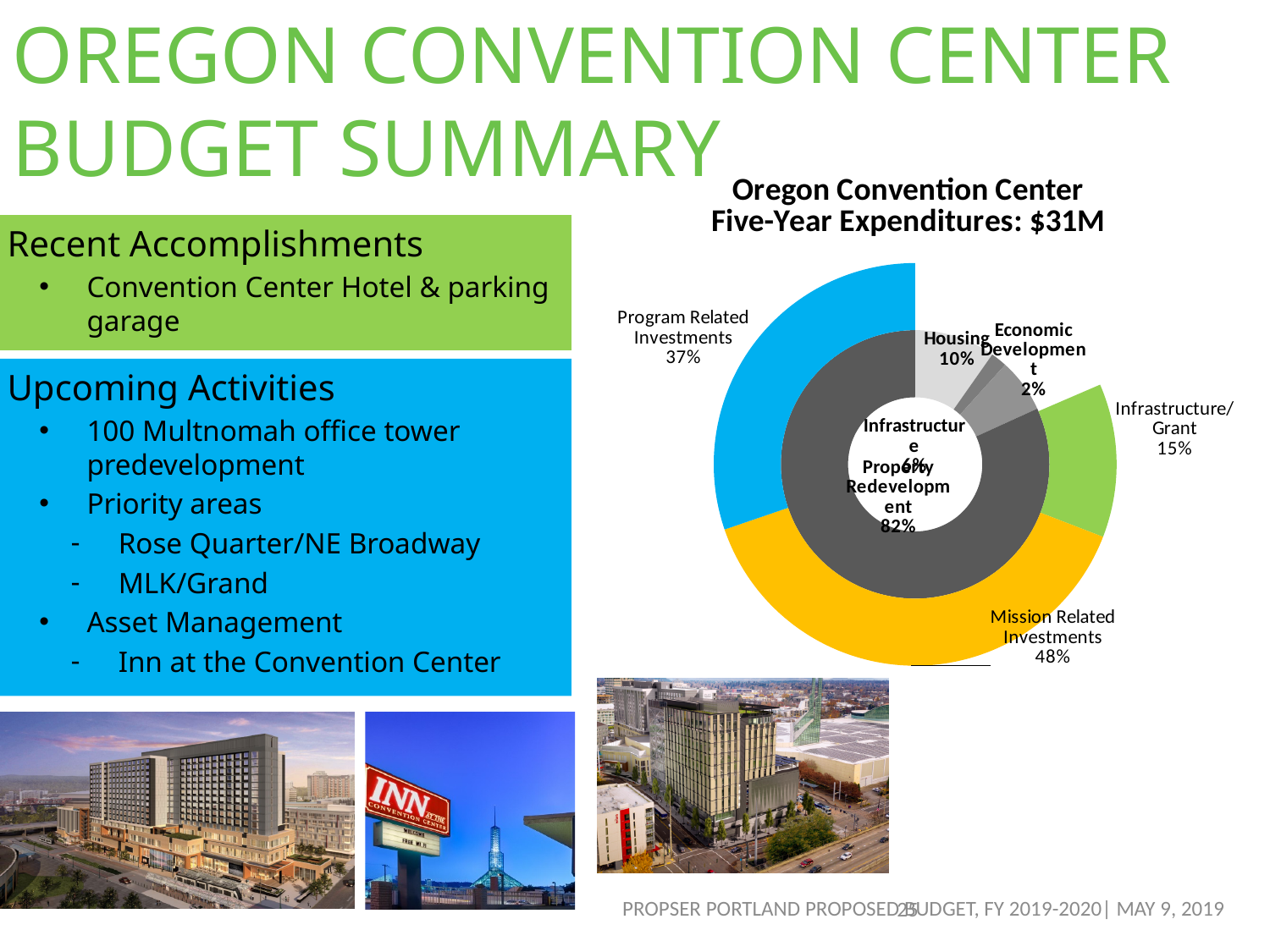
In the inner ring of the Oregon Convention Center expenditures chart, what percentage is labelled for Economic Development? 2% What kind of chart is shown under the title "Oregon Convention Center Five-Year Expenditures: $31M"? Doughnut chart In the Oregon Convention Center expenditures chart, how many percentage points larger is Mission Related Investments than Program Related Investments? 11 percentage points In the inner ring of the Oregon Convention Center expenditures chart, what percentage is labelled for Property Redevelopment? 82% According to the chart title, what is the total five-year expenditure for the Oregon Convention Center? $31M In the inner ring of the Oregon Convention Center expenditures chart, what percentage is labelled for Housing? 10% What percentage of the Oregon Convention Center five-year expenditures is Mission Related Investments? 48% In the Oregon Convention Center expenditures chart, which is larger: Program Related Investments or Infrastructure/Grant? Program Related Investments What percentage of the Oregon Convention Center five-year expenditures is Infrastructure/Grant? 15% In the outer ring of the Oregon Convention Center expenditures chart, which category has the largest share? Mission Related Investments In the outer ring of the Oregon Convention Center expenditures chart, which category has the smallest share? Infrastructure/Grant What percentage of the Oregon Convention Center five-year expenditures is Program Related Investments? 37%